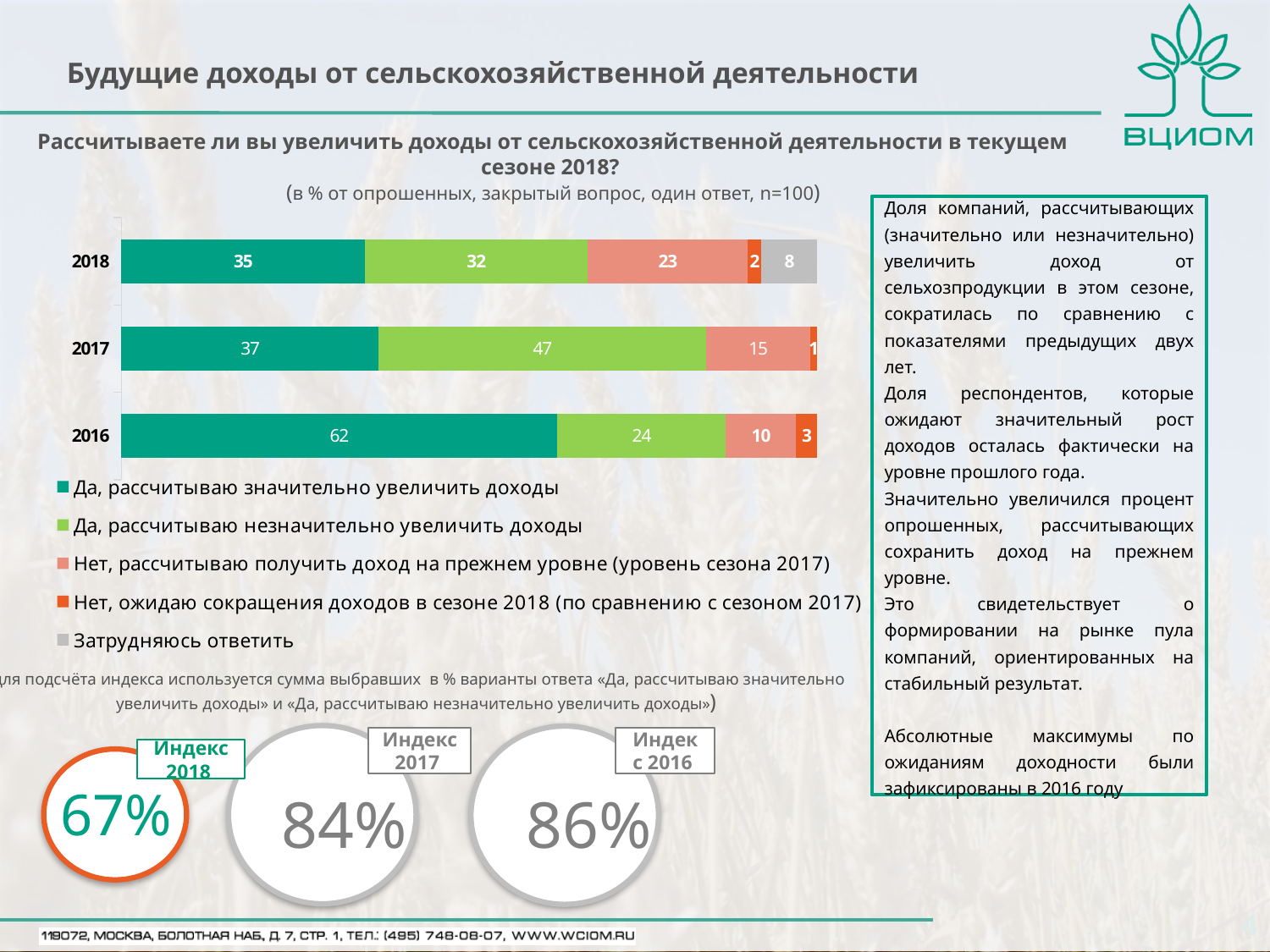
What is the difference between the 2016 and 2018 values for "Да, рассчитываю значительно увеличить доходы"? 27 Which year has the larger value for "Да, рассчитываю незначительно увеличить доходы": 2017 or 2018? 2017 What is the value for "Затрудняюсь ответить" in 2018? 8 What is the value for "Нет, рассчитываю получить доход на прежнем уровне" in 2016? 10 What is the value for "Да, рассчитываю незначительно увеличить доходы" in 2017? 47 Which year has the highest value for "Да, рассчитываю значительно увеличить доходы"? 2016 What is the value for "Да, рассчитываю значительно увеличить доходы" in 2018? 35 How many series does the legend list? 5 What kind of chart is shown on the slide? Stacked bar chart How many years (categories) are shown in the chart? 3 What is the value for "Да, рассчитываю значительно увеличить доходы" in 2016? 62 What is the total of the stacked bar for 2018? 100